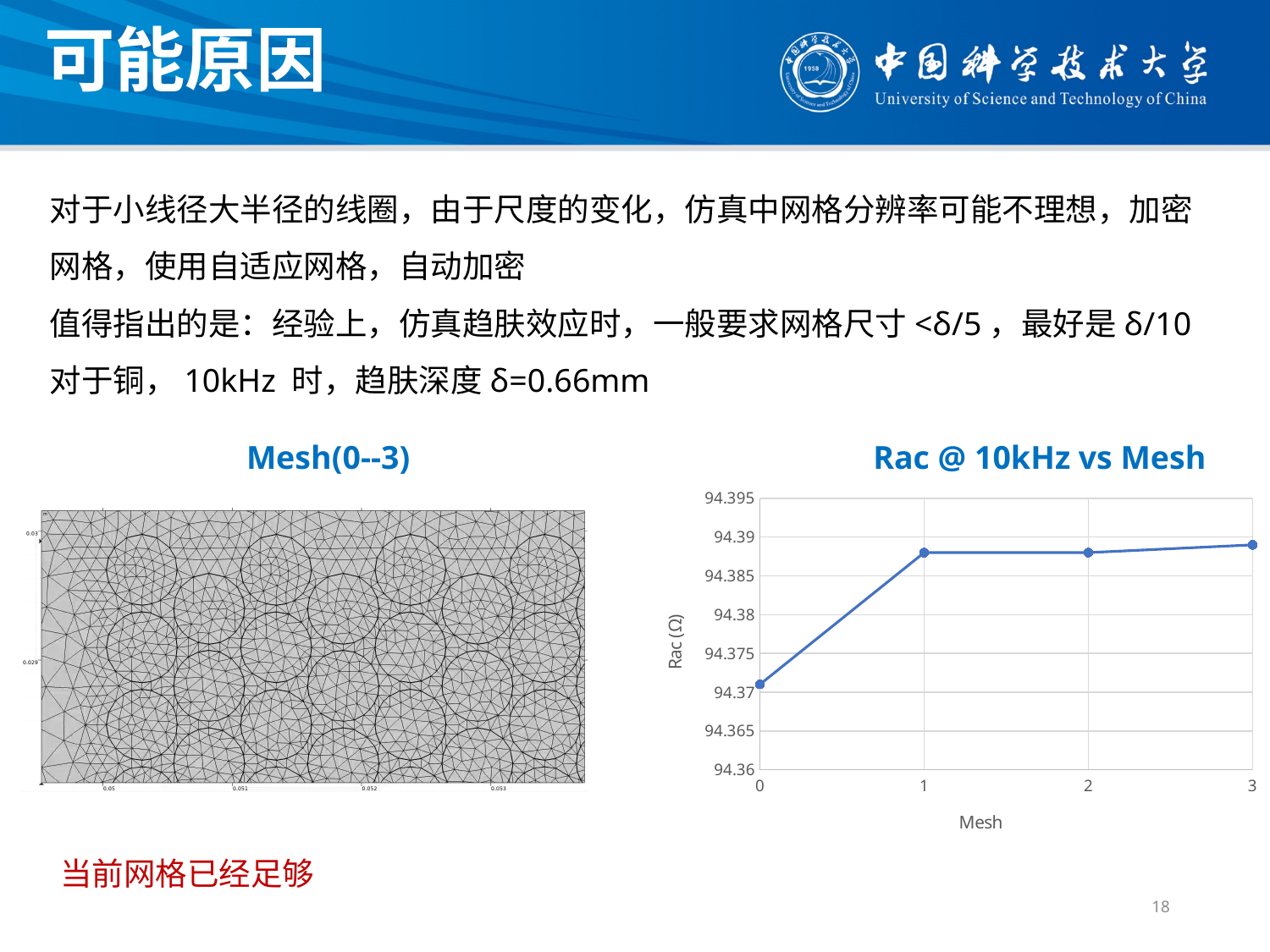
In the "Rac @ 10kHz vs Mesh" chart, is the Rac value at Mesh 3 greater or less than 94.38? greater In the "Rac @ 10kHz vs Mesh" chart, which Mesh value has the lowest Rac? 0 In the "Rac @ 10kHz vs Mesh" chart, is the Rac value at Mesh 1 greater or less than 94.385? greater In the "Rac @ 10kHz vs Mesh" chart, which has the larger Rac value: Mesh 3 or Mesh 0? Mesh 3 What is the label of the x axis in the "Rac @ 10kHz vs Mesh" chart? Mesh What is the label of the y axis in the "Rac @ 10kHz vs Mesh" chart? Rac (Ω) What kind of chart is "Rac @ 10kHz vs Mesh"? line chart In the "Rac @ 10kHz vs Mesh" chart, is the Rac value at Mesh 0 greater or less than 94.375? less How many data points are plotted in the "Rac @ 10kHz vs Mesh" chart? 4 In the "Rac @ 10kHz vs Mesh" chart, which has the larger Rac value: Mesh 0 or Mesh 1? Mesh 1 In the "Rac @ 10kHz vs Mesh" chart, does Rac generally rise or fall as Mesh increases from 0 to 3? rise